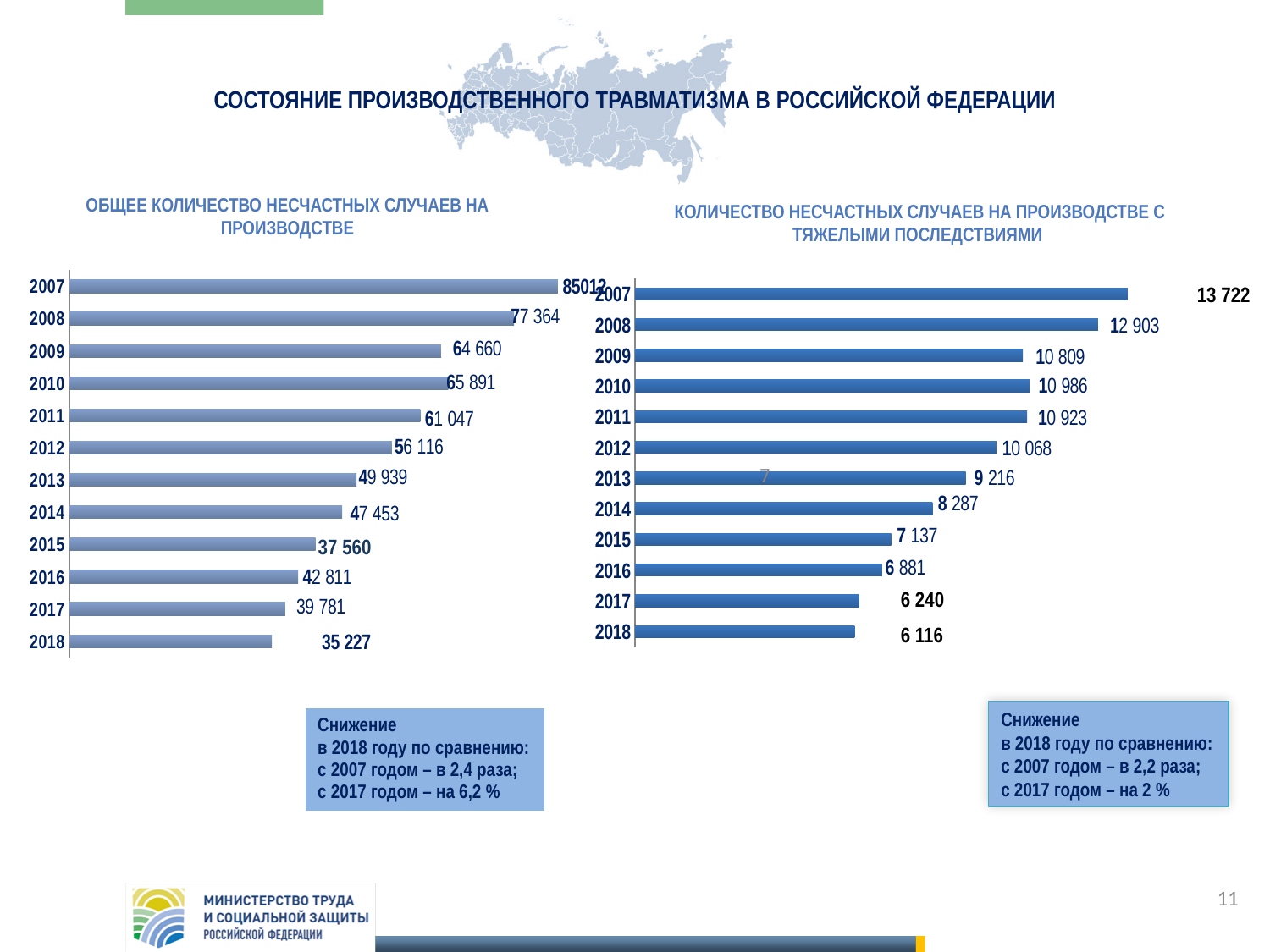
In the left chart (total number of workplace accidents), what is the value for 2018? 35 227 In the right chart (accidents with severe consequences), what is the value for 2013? 9 216 In the right chart (accidents with severe consequences), what is the difference between the 2017 and 2018 values? 124 In the left chart (total number of workplace accidents), which year has the highest value? 2007 In the right chart (accidents with severe consequences), what is the value for 2007? 13 722 In the right chart (accidents with severe consequences), do the values generally rise or fall from 2007 to 2018? fall In the right chart (accidents with severe consequences), which year has the lowest value? 2018 In the right chart (accidents with severe consequences), is the value for 2014 greater or less than the value for 2015? greater In the left chart (total number of workplace accidents), what is the value for 2012? 56 116 In the left chart (total number of workplace accidents), which is larger: the value for 2009 or the value for 2010? 2010 What type of chart is used on the left side of the slide? bar chart How many years are shown in the right chart (accidents with severe consequences)? 12